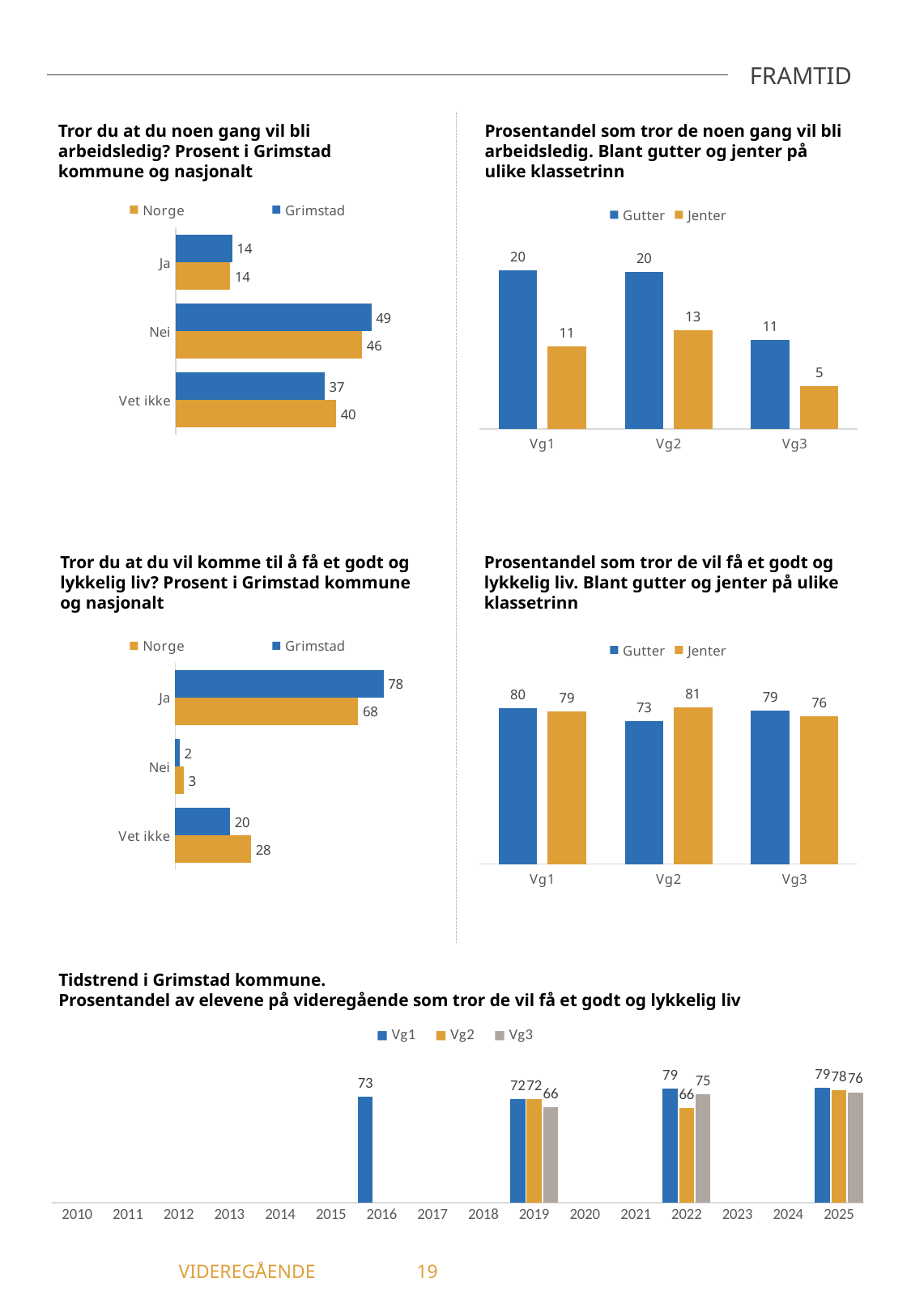
In the middle-right chart 'Prosentandel som tror de vil få et godt og lykkelig liv', what is the difference between the Jenter and Gutter values for Vg2? 8 In the middle-right chart 'Prosentandel som tror de vil få et godt og lykkelig liv', what is the Jenter value for Vg2? 81 In the top-right chart 'Prosentandel som tror de noen gang vil bli arbeidsledig', how many series does the legend list? 2 What kind of chart is the bottom chart 'Tidstrend i Grimstad kommune'? Bar chart In the top-right chart 'Prosentandel som tror de noen gang vil bli arbeidsledig', which class level has the lowest Gutter value? Vg3 In the top-left chart 'Tror du at du noen gang vil bli arbeidsledig?', what is the difference between the Norge and Grimstad values for 'Vet ikke'? 3 In the top-right chart 'Prosentandel som tror de noen gang vil bli arbeidsledig', what is the Jenter value for Vg3? 5 In the top-left chart 'Tror du at du noen gang vil bli arbeidsledig?', what is the Grimstad value for 'Nei'? 49 In the middle-left chart 'Tror du at du vil komme til å få et godt og lykkelig liv?', which is larger for 'Vet ikke': Norge or Grimstad? Norge In the bottom chart 'Tidstrend i Grimstad kommune', how many series does the legend list? 3 In the bottom chart 'Tidstrend i Grimstad kommune', what is the Vg2 value for 2022? 66 In the middle-left chart 'Tror du at du vil komme til å få et godt og lykkelig liv?', what is the Norge value for 'Ja'? 68